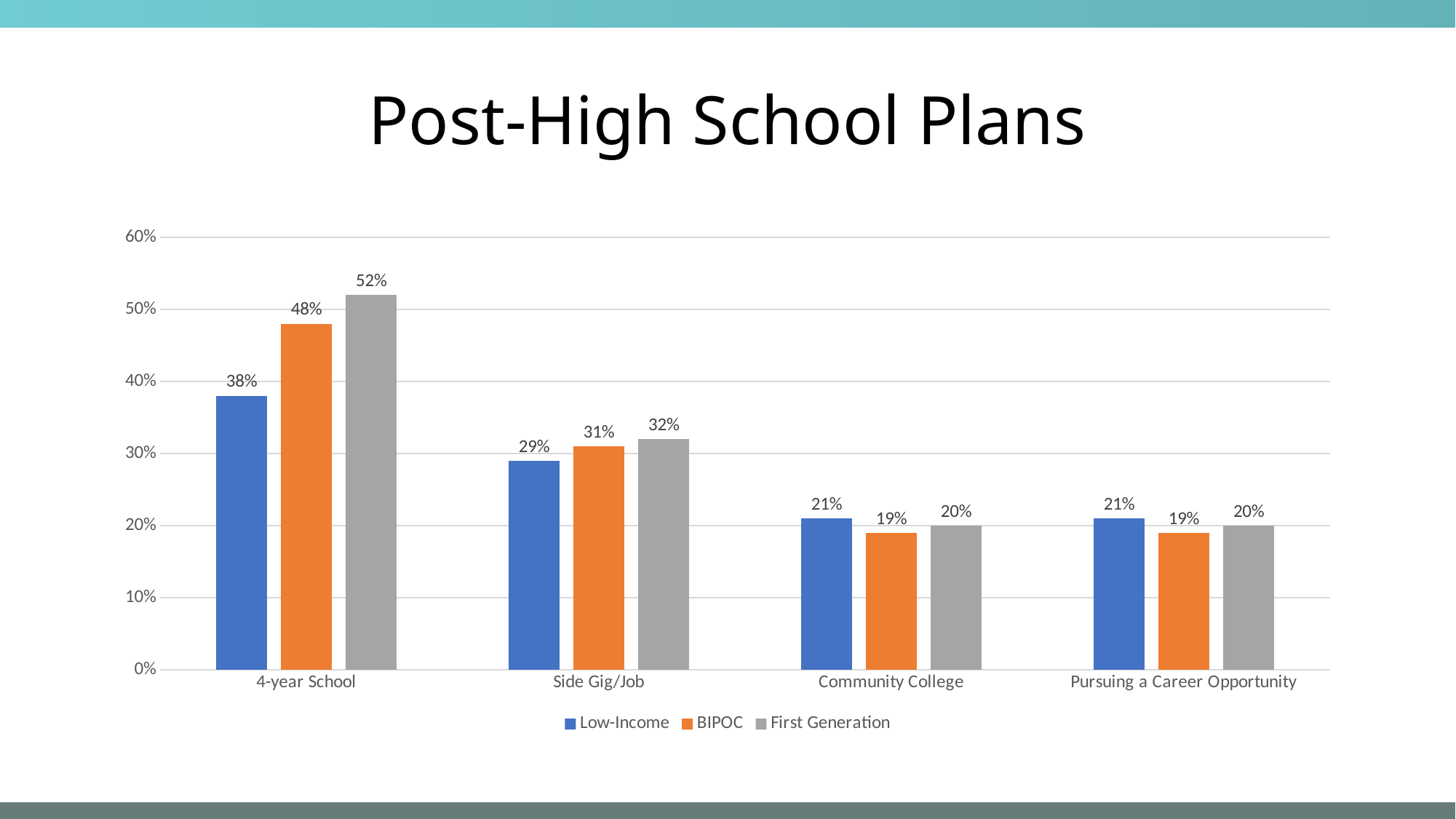
What kind of chart is shown on the slide? Bar chart What is the difference between the First Generation and Low-Income values for 4-year School? 14% Which series has the lowest value for Pursuing a Career Opportunity? BIPOC What is the Low-Income value for 4-year School? 38% How many series does the legend list? 3 How many categories are shown on the x axis? 4 What is the First Generation value for Side Gig/Job? 32% Which is larger for Side Gig/Job: the BIPOC value or the Low-Income value? BIPOC What is the title of the chart? Post-High School Plans Is the BIPOC value for 4-year School greater or less than 40%? greater What is the BIPOC value for Community College? 19% Which category has the highest First Generation value? 4-year School